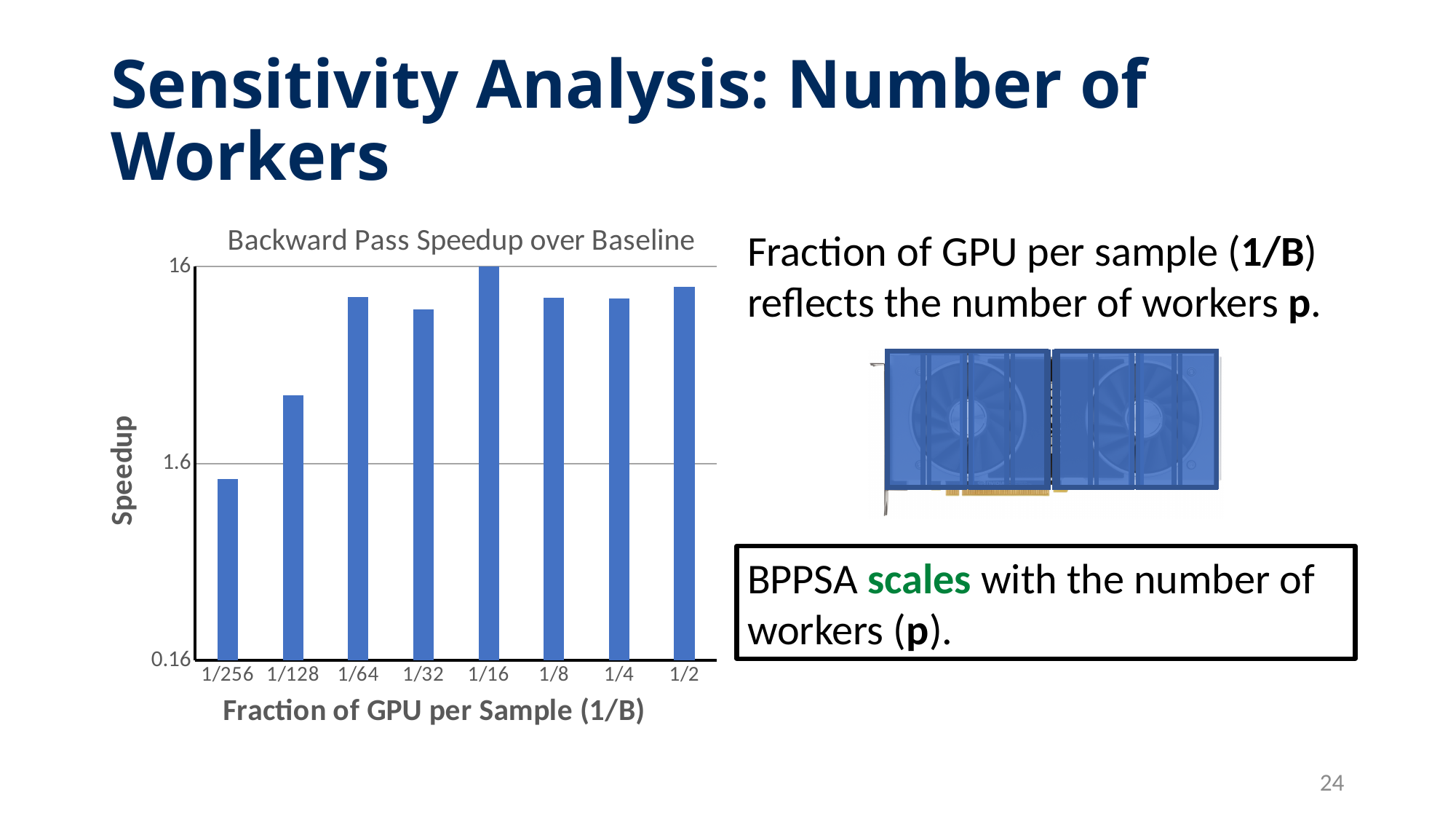
Which has a higher speedup, 1/256 or 1/128? 1/128 How many categories are shown on the x axis of the chart? 8 Does the speedup generally rise or fall as the fraction of GPU per sample increases from 1/256 to 1/2? rise What kind of chart is shown on the slide? bar chart Which category has the highest speedup in the chart? 1/16 Is the speedup for 1/128 greater or less than 1.6? greater Which has a higher speedup, 1/128 or 1/2? 1/2 What is the title of the chart? Backward Pass Speedup over Baseline Is the speedup for 1/2 greater or less than 16? less What is the label of the x axis of the chart? Fraction of GPU per Sample (1/B) Is the speedup for 1/256 greater or less than 1.6? less Which category has the lowest speedup in the chart? 1/256